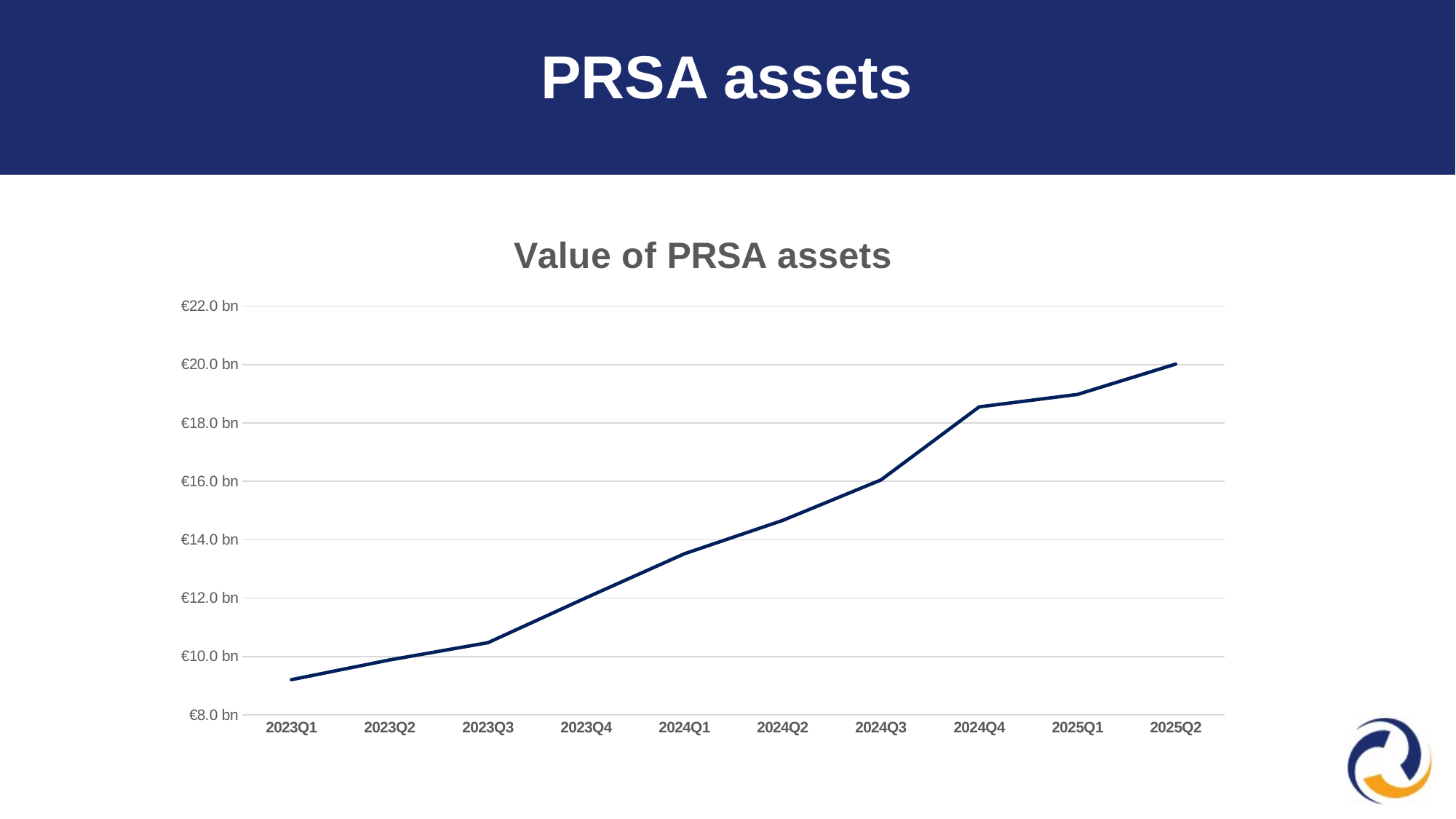
What is the title of the chart? Value of PRSA assets Is the value for 2024Q1 greater or less than €14.0 bn? less What kind of chart is shown on the slide? line chart Which quarter has the lowest value of PRSA assets? 2023Q1 Which is larger, the value for 2024Q3 or the value for 2024Q4? 2024Q4 Do the values of PRSA assets rise or fall from 2023Q1 to 2025Q2? rise Is the value for 2023Q1 greater or less than €10.0 bn? less Which quarter has the highest value of PRSA assets? 2025Q2 Is the value for 2024Q2 greater or less than €14.0 bn? greater How many quarters are plotted on the x axis? 10